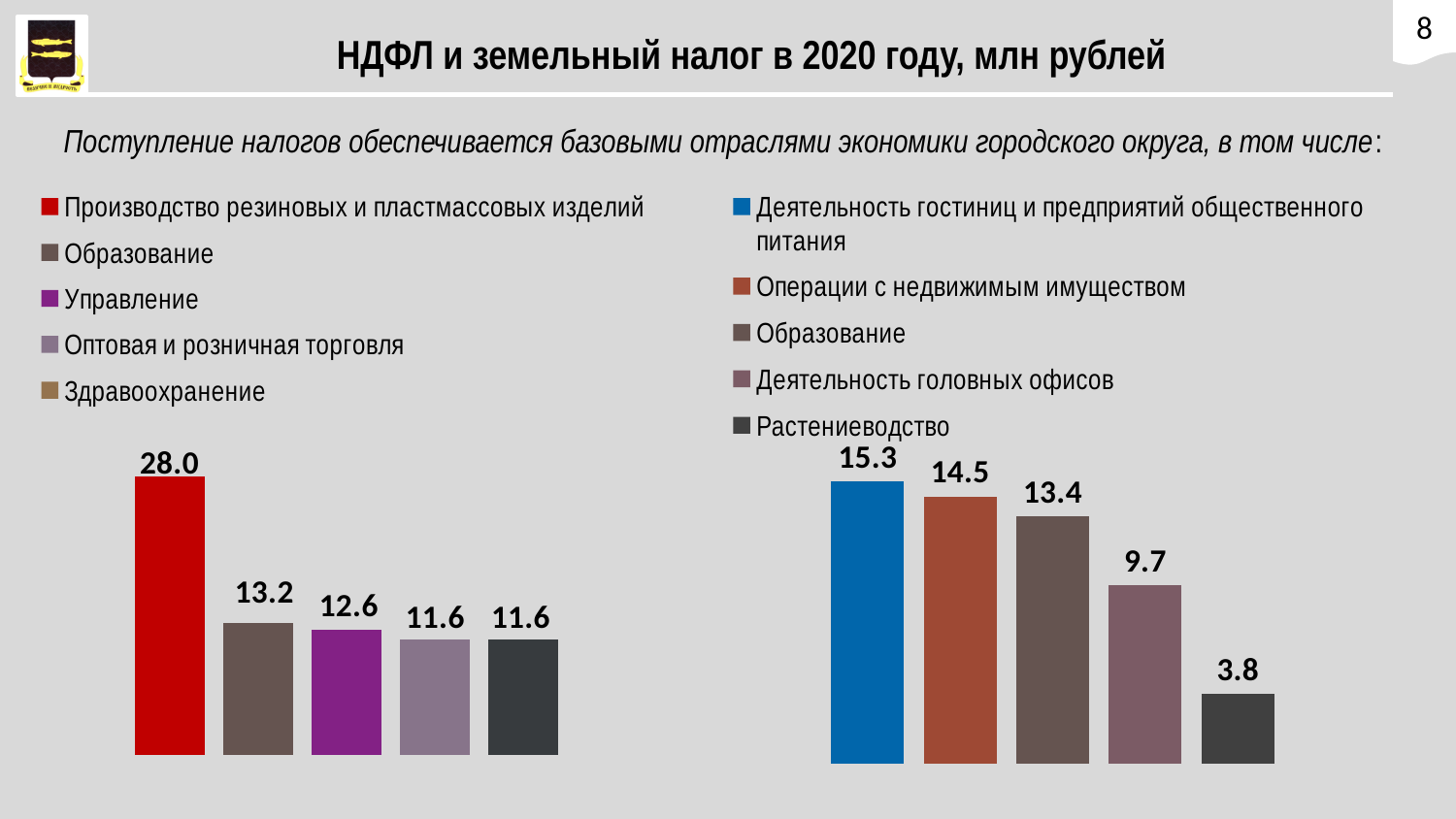
How many categories does the right chart show? 5 In the left chart, what is the value for Управление? 12.6 In the right chart, which category has the highest value? Деятельность гостиниц и предприятий общественного питания In the right chart, what is the difference between Деятельность головных офисов and Растениеводство? 5.9 In the left chart, what is the value for Производство резиновых и пластмассовых изделий? 28.0 Which is larger: Образование in the left chart or Образование in the right chart? Образование in the right chart In the right chart, what is the value for Растениеводство? 3.8 In the right chart, which category has the lowest value? Растениеводство What type of chart is the left chart? Bar chart In the left chart, which category has the highest value? Производство резиновых и пластмассовых изделий In the right chart, what is the value for Операции с недвижимым имуществом? 14.5 In the left chart, what is the difference between Производство резиновых и пластмассовых изделий and Образование? 14.8